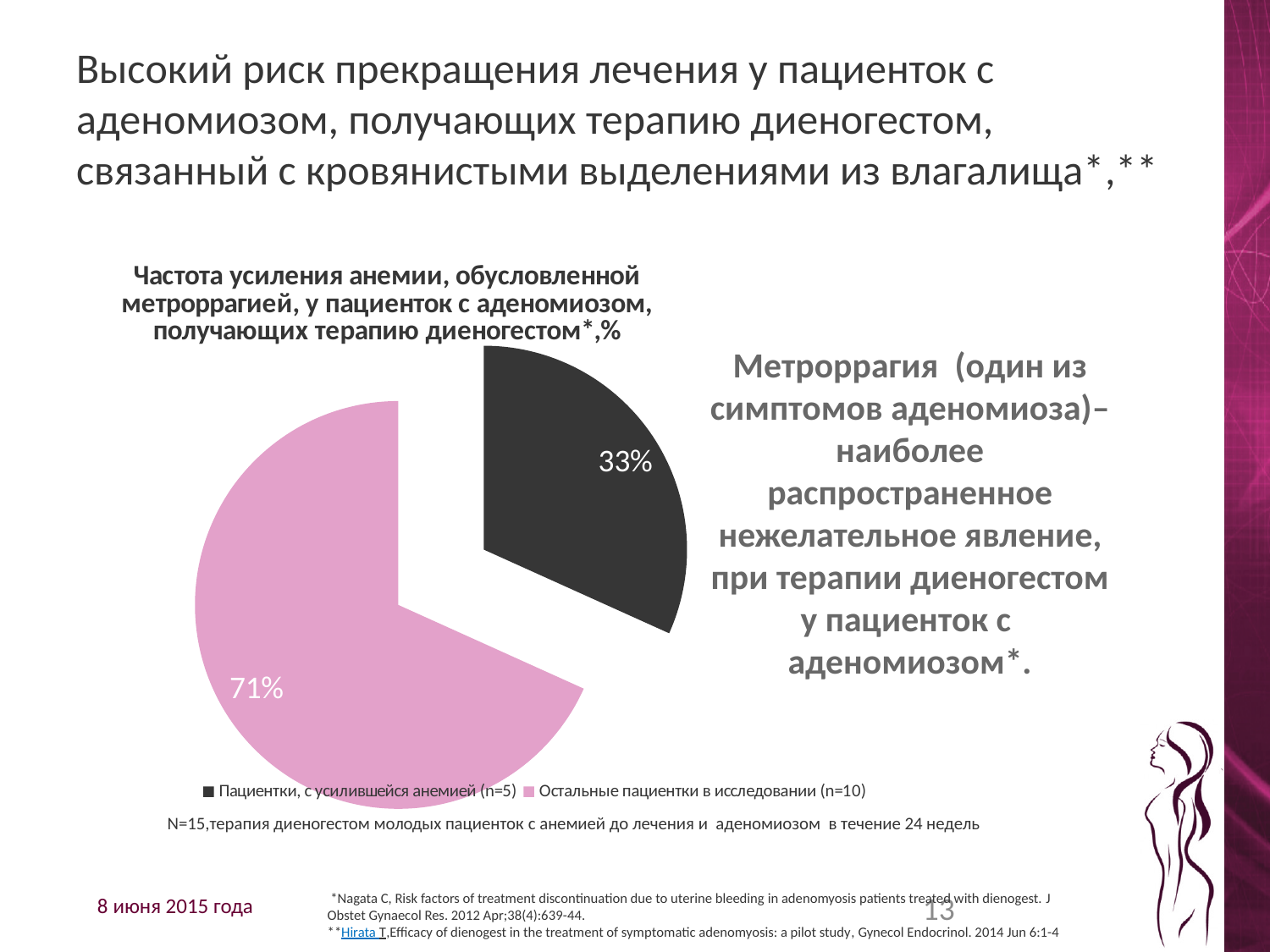
What is the title of the pie chart? Частота усиления анемии, обусловленной метроррагией, у пациенток с аденомиозом, получающих терапию диеногестом*,% What percentage is shown for the slice 'Остальные пациентки в исследовании (n=10)'? 71% What colour is the slice for 'Пациентки, с усилившейся анемией (n=5)'? dark grey/black What type of chart is shown on the slide? pie chart What percentage is shown for the slice 'Пациентки, с усилившейся анемией (n=5)'? 33% Which slice of the pie chart is the smallest? Пациентки, с усилившейся анемией (n=5) Which slice of the pie chart is the largest? Остальные пациентки в исследовании (n=10) What is the difference in percentage points between the two slices of the pie chart? 38 How many entries does the legend of the pie chart list? 2 How many slices does the pie chart have? 2 Which is larger: the slice for 'Пациентки, с усилившейся анемией (n=5)' or the slice for 'Остальные пациентки в исследовании (n=10)'? Остальные пациентки в исследовании (n=10)